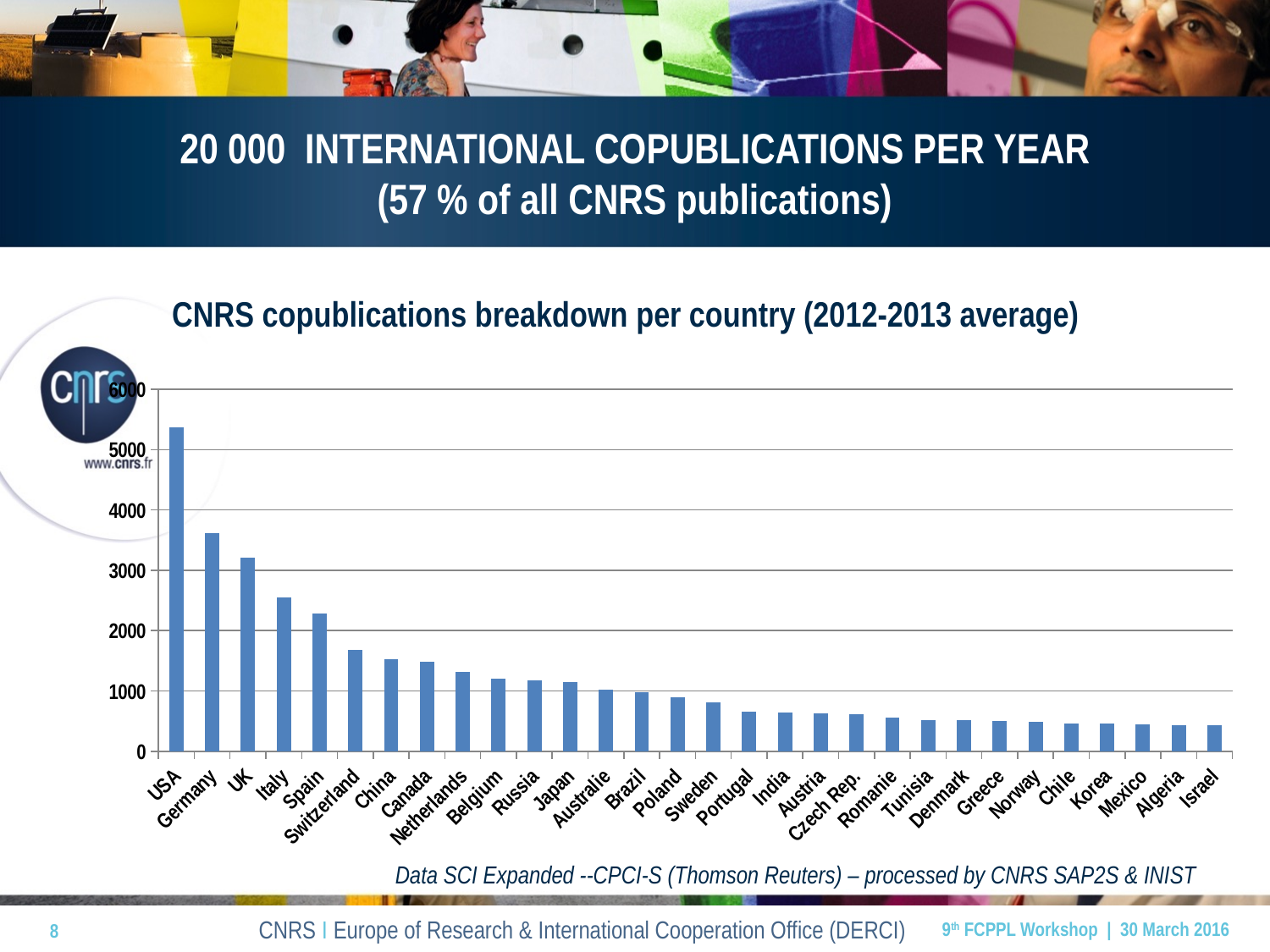
How many countries are shown on the x axis of the chart? 30 Which has the larger value, Japan or Brazil? Japan What kind of chart is shown on the slide? Bar chart Which country has the highest number of CNRS copublications in the chart? USA Is the value for USA greater or less than 5000? greater What is the title of the chart? CNRS copublications breakdown per country (2012-2013 average) Is the value for Switzerland greater or less than 2000? less Is the value for Germany greater or less than 3000? greater Which has the larger value, Germany or UK? Germany Do the values rise or fall moving from left to right along the x axis? fall